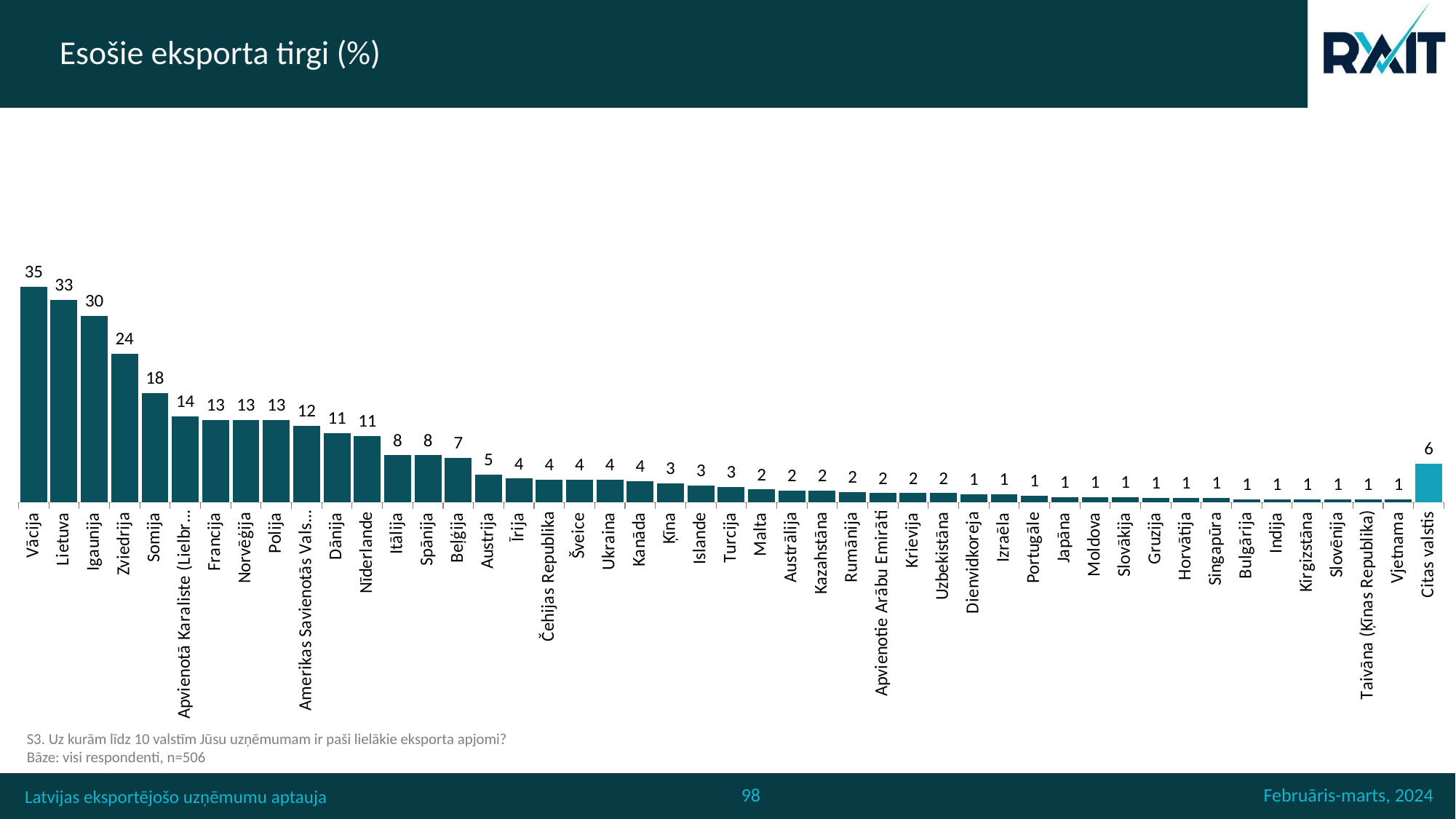
What is the difference between the values for Vācija and Lietuva? 2 Which has a larger value, Austrija or Beļģija? Beļģija What is the value for Polija? 13 What kind of chart is shown on the slide? Bar chart Which has a larger value, Dānija or Itālija? Dānija What is the difference between the values for Igaunija and Zviedrija? 6 What is the value for Zviedrija? 24 Which country has the highest value? Vācija What is the value for Citas valstis? 6 What is the value for Vācija? 35 What is the title of the chart? Esošie eksporta tirgi (%) What is the value for Somija? 18